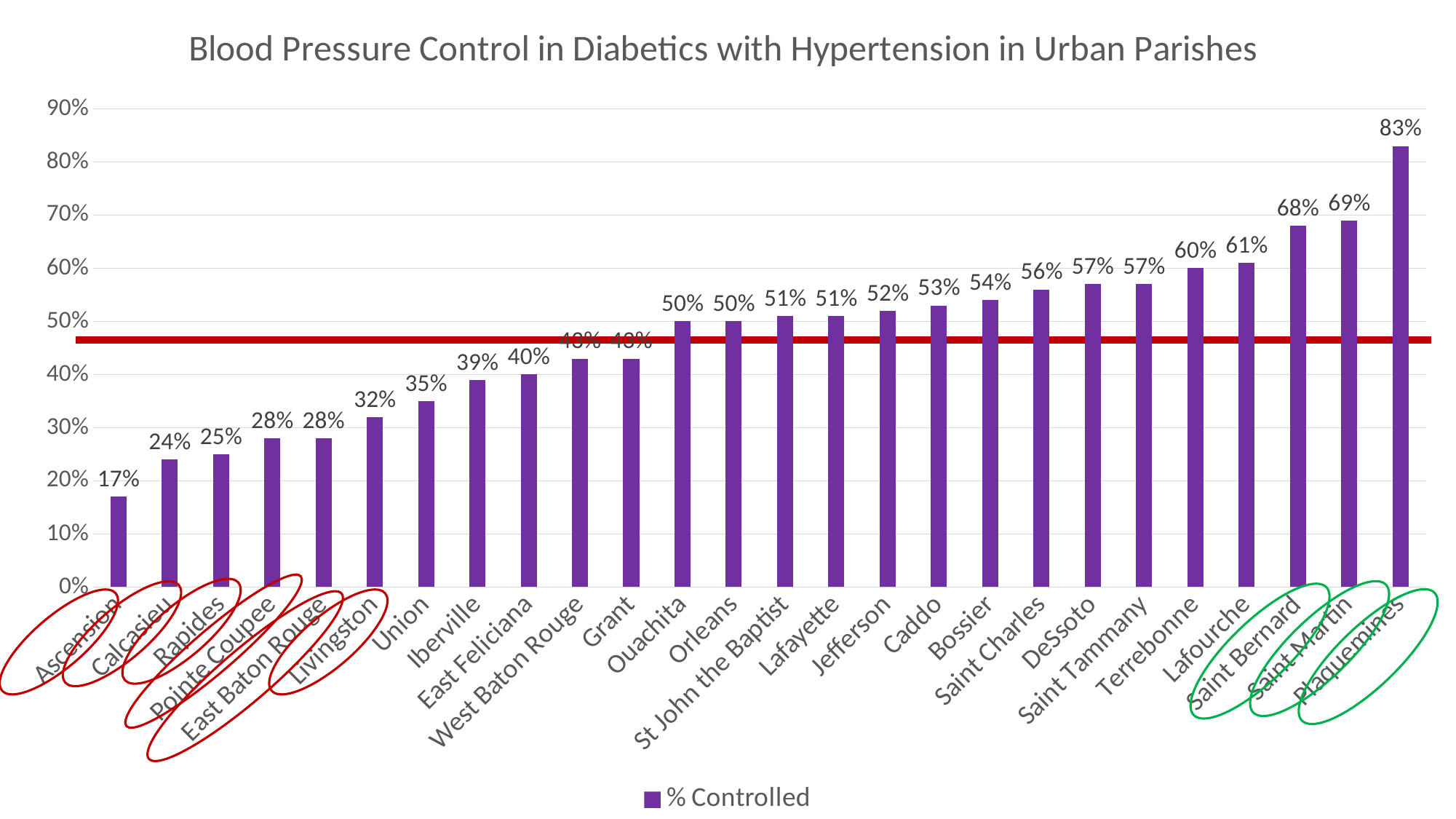
What is the difference in % Controlled between Plaquemines and Ascension? 66% What is the % Controlled value for Jefferson? 52% Which parish has the lowest % Controlled? Ascension What is the % Controlled value for Ascension? 17% What is the difference in % Controlled between Saint Martin and Saint Bernard? 1% Which has a higher % Controlled, Lafourche or Livingston? Lafourche How many series does the legend list? 1 What type of chart is shown on the slide? Bar chart Is the value for Terrebonne greater or less than 50%? greater Which parish has the highest % Controlled? Plaquemines What is the % Controlled value for Plaquemines? 83% How many parishes are shown on the chart? 26